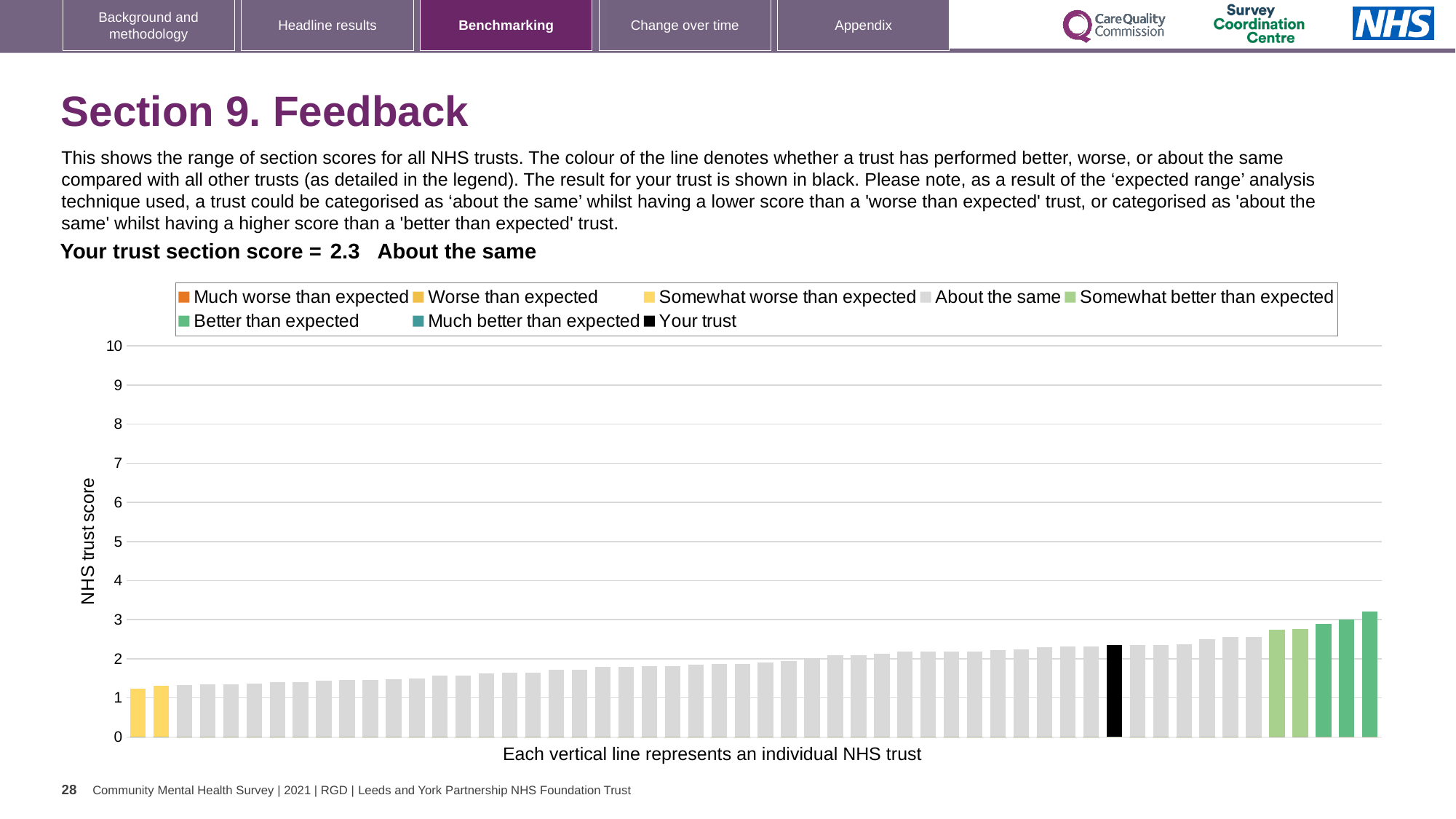
Is the value of the shortest bar greater or less than 2? less Is the value for your trust greater or less than 2? greater Do the bar values rise or fall from left to right along the x axis? rise How is your trust's section score categorised compared with other trusts? About the same What kind of chart is shown on the slide? bar chart What is the section score for your trust? 2.3 Which is larger, the value for your trust or the value of the leftmost bar? your trust Is the value of the tallest bar greater or less than 4? less How many bars in the chart are coloured yellow? 2 What is the label on the y axis of the chart? NHS trust score How many entries does the legend list? 8